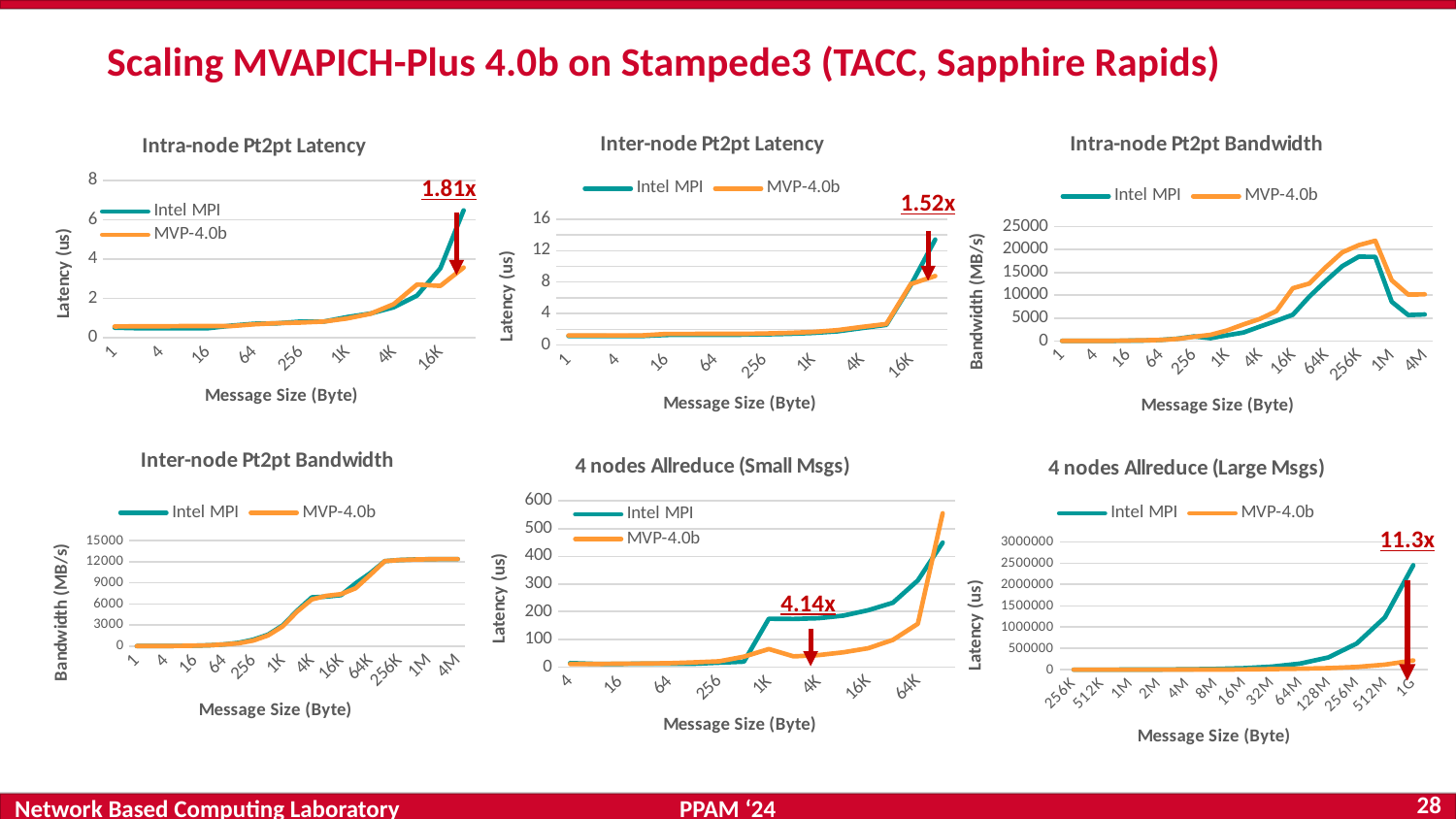
In the 4 nodes Allreduce (Large Msgs) chart, which series has the higher latency at message size 1G? Intel MPI What are the two series named in the legend of the 4 nodes Allreduce (Small Msgs) chart? Intel MPI and MVP-4.0b In the Inter-node Pt2pt Bandwidth chart, is the bandwidth at message size 4M greater or less than 9000? greater In the Intra-node Pt2pt Bandwidth chart, is the peak value of Intel MPI greater or less than 20000? less What type of chart is the Intra-node Pt2pt Latency chart? line chart In the Inter-node Pt2pt Latency chart, is the highest Intel MPI latency greater or less than 12? greater In the Intra-node Pt2pt Bandwidth chart, which series has the higher bandwidth at message size 256K? MVP-4.0b What speedup factor is annotated on the 4 nodes Allreduce (Large Msgs) chart? 11.3x How many series does the legend of the Inter-node Pt2pt Bandwidth chart list? 2 How many charts are shown on the slide? 6 In the 4 nodes Allreduce (Large Msgs) chart, does the Intel MPI latency rise or fall as message size increases? rise